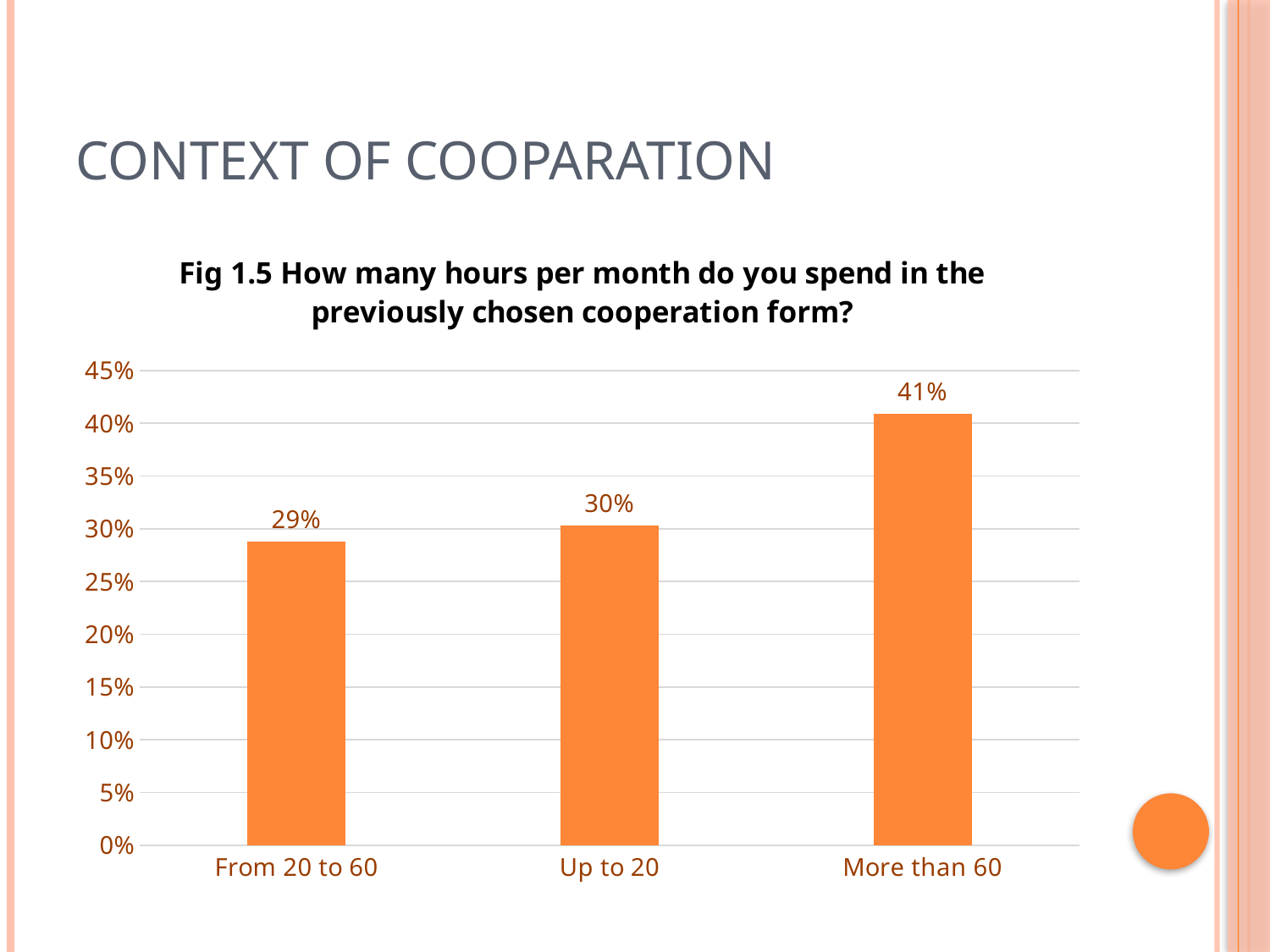
Which category has the lowest value? From 20 to 60 What kind of chart is shown on the slide? Bar chart How many categories are shown in the chart? 3 What is the value for "Up to 20"? 30% What is the value for "More than 60"? 41% What is the difference between the values for "More than 60" and "Up to 20"? 11% What is the difference between the values for "More than 60" and "From 20 to 60"? 12% Which category has the highest value? More than 60 Which is larger, the value for "More than 60" or the value for "Up to 20"? More than 60 What is the value for "From 20 to 60"? 29% Is the value for "More than 60" greater or less than 35%? greater What is the title of the chart? Fig 1.5 How many hours per month do you spend in the previously chosen cooperation form?